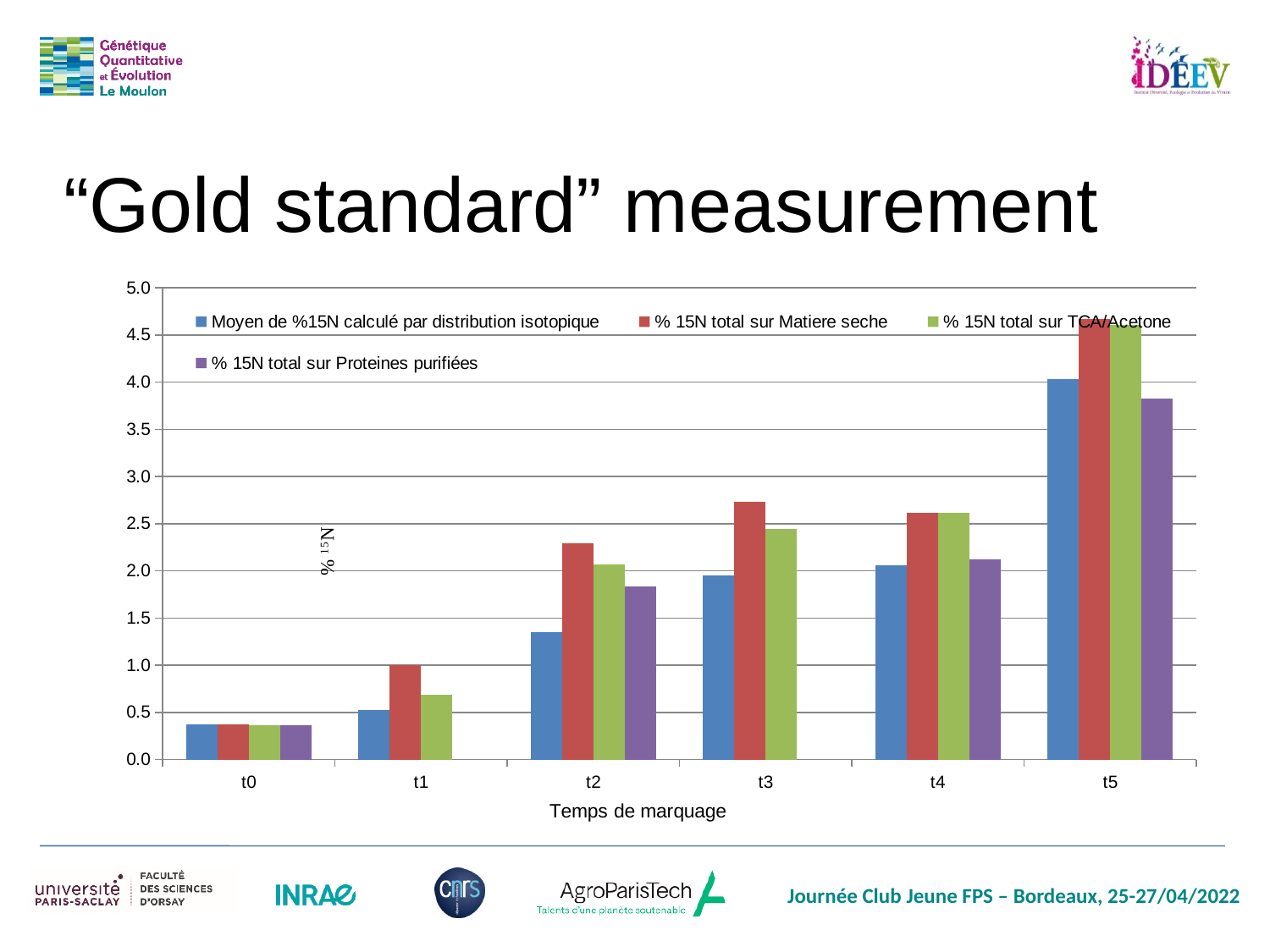
What is the title of the x axis? Temps de marquage Is the value for '% 15N total sur Proteines purifiées' at t5 greater or less than 3.5? greater Which time point has the highest value for the series '% 15N total sur Matiere seche'? t5 Do the values for 'Moyen de %15N calculé par distribution isotopique' rise or fall from t0 to t5? rise At t1, which is larger: '% 15N total sur Matiere seche' or '% 15N total sur TCA/Acetone'? % 15N total sur Matiere seche Is the value for '% 15N total sur Matiere seche' at t5 greater or less than 4.5? greater Is the value for 'Moyen de %15N calculé par distribution isotopique' at t2 greater or less than 1.5? less What kind of chart is shown on the slide? bar chart At t3, which is larger: '% 15N total sur Matiere seche' or 'Moyen de %15N calculé par distribution isotopique'? % 15N total sur Matiere seche Which time point has the lowest value for '% 15N total sur TCA/Acetone'? t0 How many series does the legend list? 4 How many time points (categories) are shown on the x axis? 6